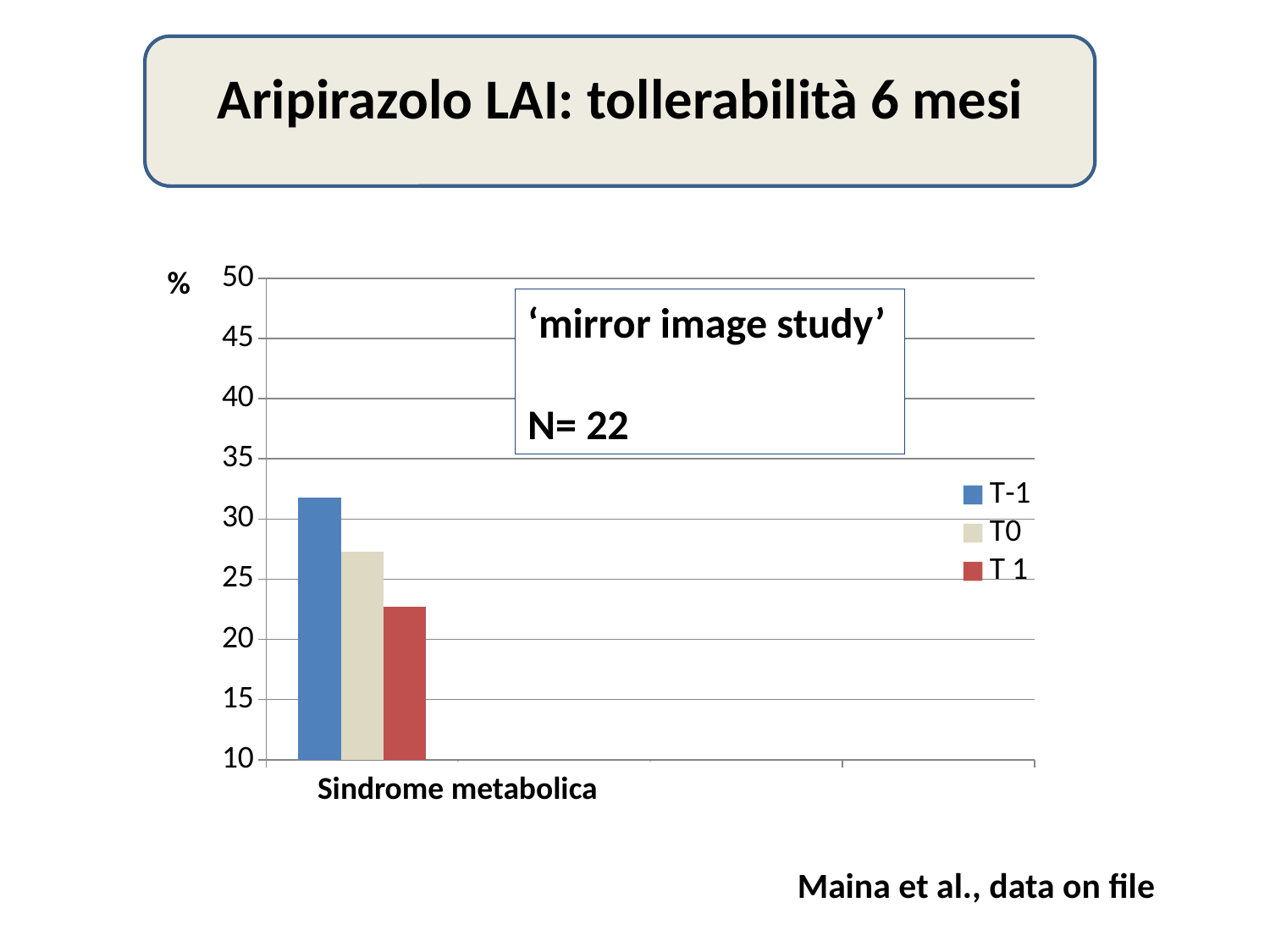
Is the T 1 value for Sindrome metabolica greater or less than 25? less What label is shown on the y axis of the chart? % Which is larger for Sindrome metabolica, the T-1 value or the T0 value? T-1 Which series has the lowest value for Sindrome metabolica? T 1 How many categories are shown on the x axis? 1 How many series does the legend list? 3 What kind of chart is shown on the slide? bar chart Is the T0 value for Sindrome metabolica greater or less than 25? greater Which series has the highest value for Sindrome metabolica? T-1 What is the title of the slide containing the chart? Aripirazolo LAI: tollerabilità 6 mesi Do the values for Sindrome metabolica rise or fall going from T-1 to T0 to T 1? fall Is the T-1 value for Sindrome metabolica greater or less than 30? greater